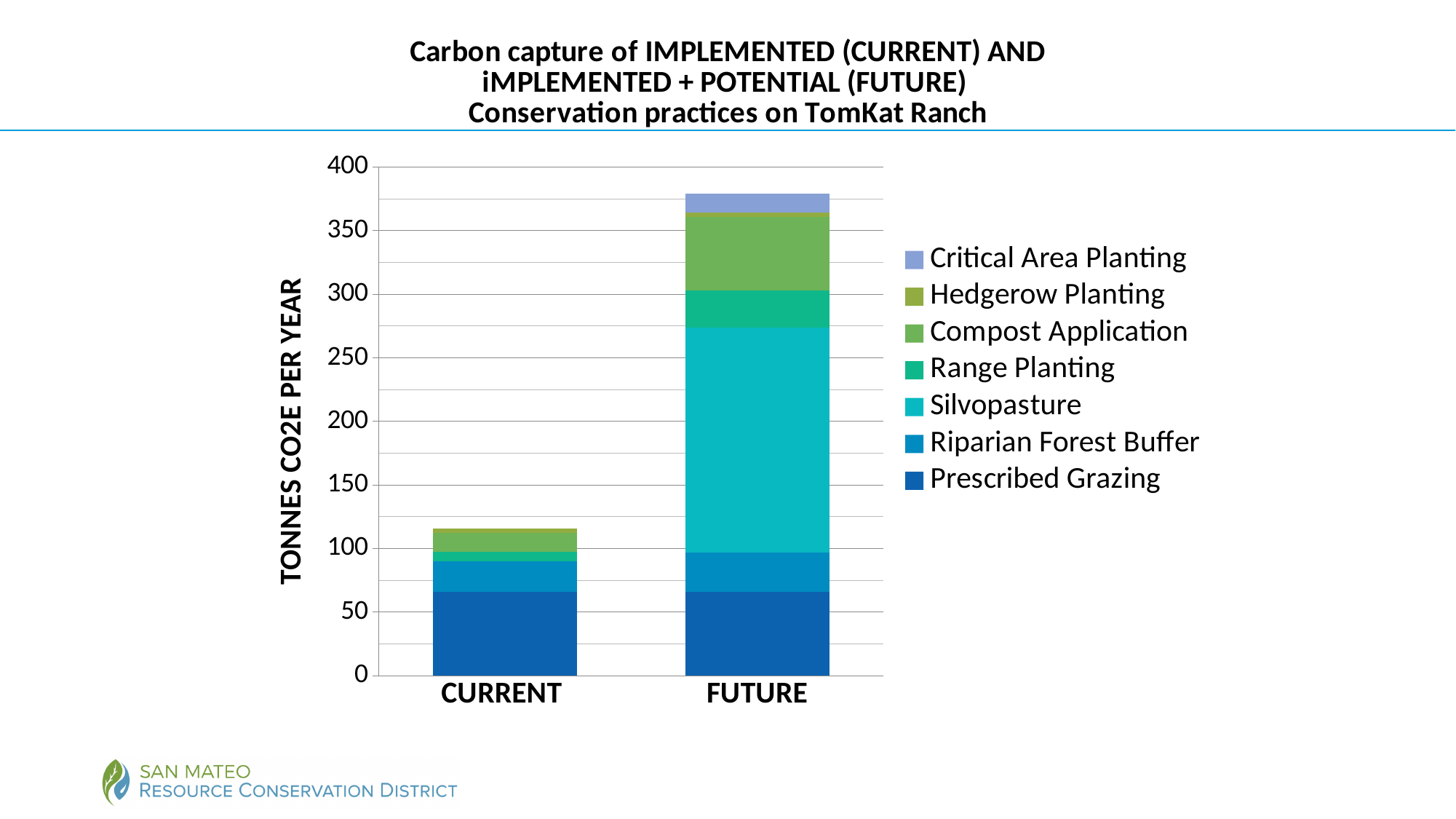
Is the total value of the CURRENT bar greater or less than 150? less Is the Prescribed Grazing segment of the CURRENT bar greater or less than 50? greater Which category has the lowest total tonnes CO2e per year? CURRENT What is the label on the vertical axis? TONNES CO2E PER YEAR How many bars (categories) are plotted on the x axis? 2 Is the total value of the FUTURE bar greater or less than 350? greater Which bar has the greater total carbon capture, CURRENT or FUTURE? FUTURE How many series does the legend list? 7 Do the bar totals rise or fall from CURRENT to FUTURE? rise What kind of chart is shown on the slide? Stacked bar chart Which series is shown in the darkest blue at the bottom of each bar? Prescribed Grazing